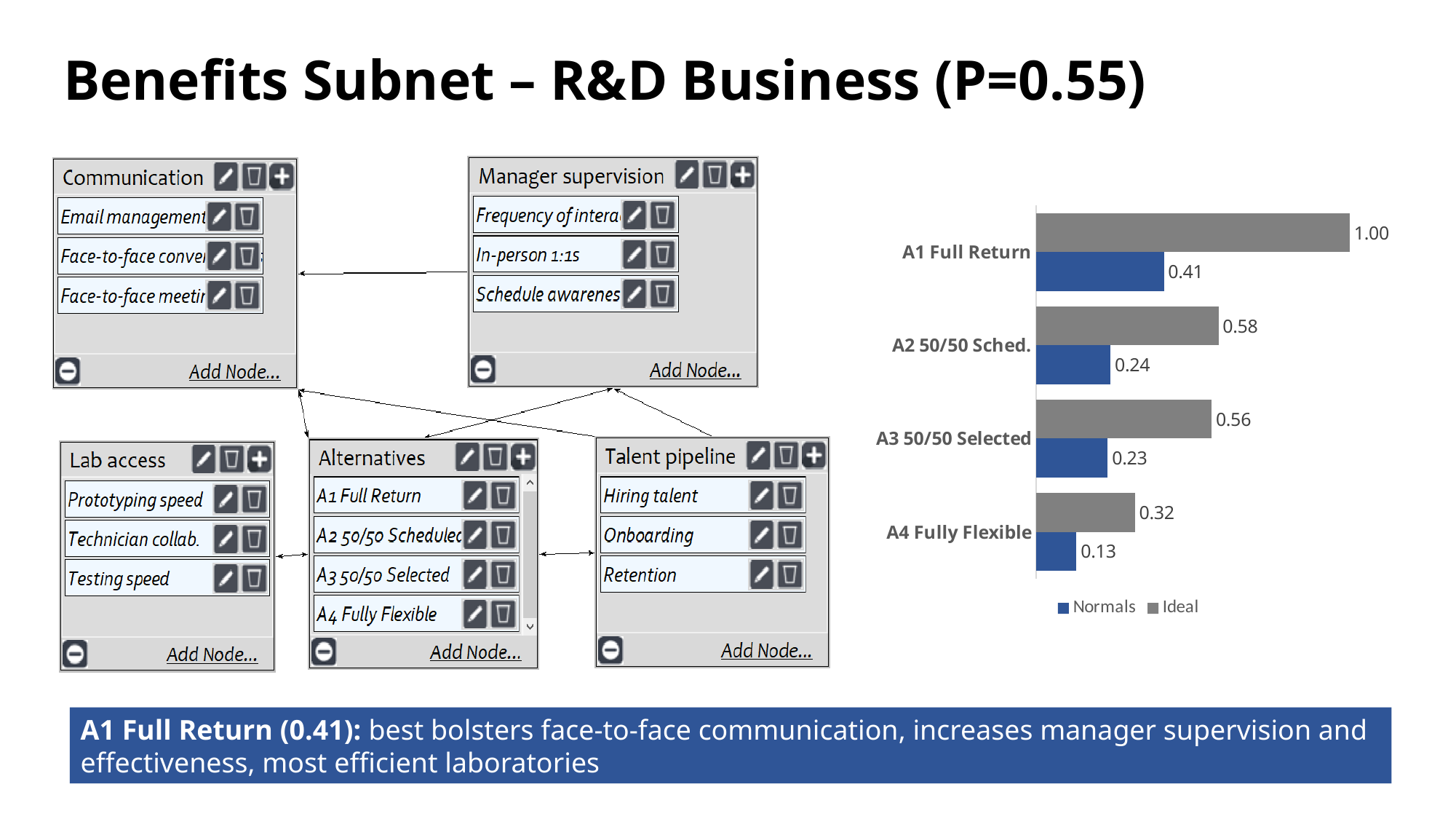
Which category has the lowest Normals value? A4 Fully Flexible What is the Ideal value for A2 50/50 Sched.? 0.58 How many categories are shown on the chart? 4 Which is larger, the Normals value for A2 50/50 Sched. or the Normals value for A4 Fully Flexible? A2 50/50 Sched. Which category has the highest Ideal value? A1 Full Return What kind of chart is shown on the slide? Bar chart What is the difference between the Ideal and Normals values for A1 Full Return? 0.59 What is the Ideal value for A3 50/50 Selected? 0.56 What is the Normals value for A4 Fully Flexible? 0.13 Which series is shown in blue? Normals What is the Normals value for A1 Full Return? 0.41 How many series does the legend list? 2